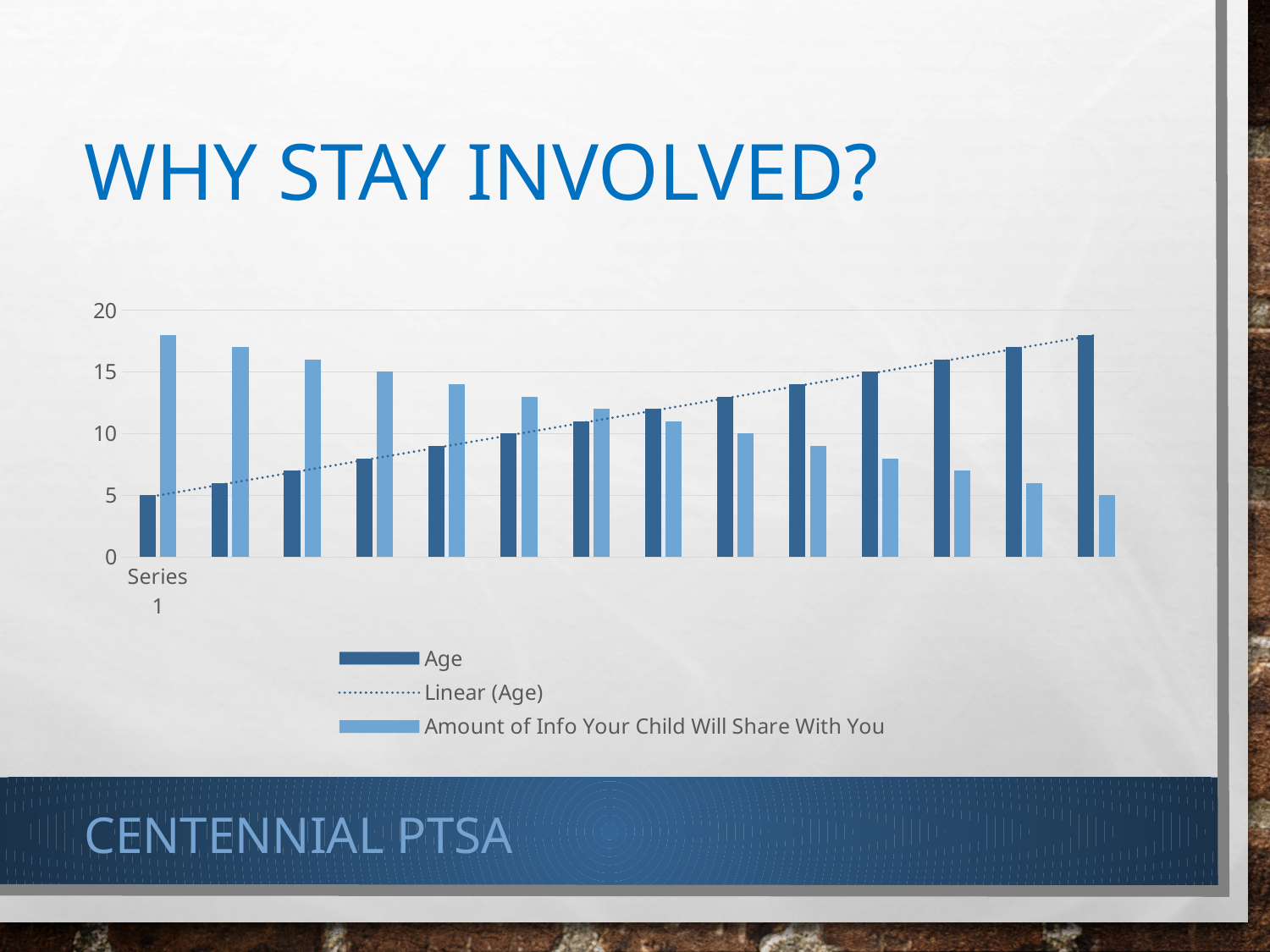
How many groups of bars are plotted along the x axis? 14 What kind of chart is shown on the slide? bar chart For Series 1, which is larger: Age or Amount of Info Your Child Will Share With You? Amount of Info Your Child Will Share With You Do the Age bars rise or fall from left to right along the x axis? rise Is the 'Amount of Info Your Child Will Share With You' value for the rightmost group of bars greater or less than 10? less Which legend entry is shown in the lighter blue colour? Amount of Info Your Child Will Share With You How many entries does the chart legend list? 3 Is the 'Amount of Info Your Child Will Share With You' value for Series 1 greater or less than 15? greater What does the dotted line in the chart represent, according to the legend? Linear (Age) Do the 'Amount of Info Your Child Will Share With You' bars rise or fall from left to right along the x axis? fall What is the Age value for the first category, Series 1? 5 Is the Age value for the rightmost group of bars greater or less than 15? greater